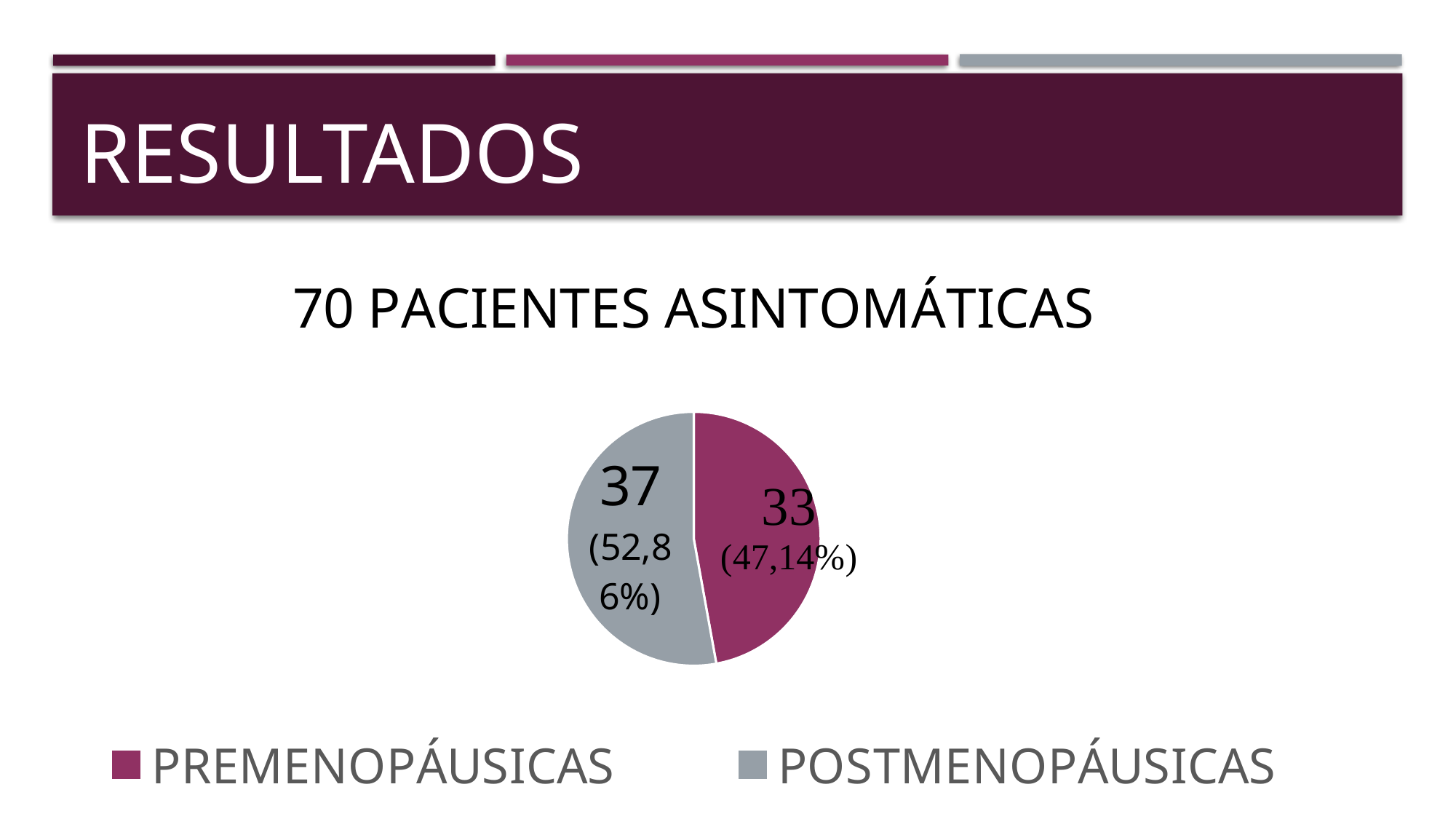
What is the difference between the number of POSTMENOPÁUSICAS and PREMENOPÁUSICAS patients? 4 What kind of chart is shown on the slide? pie chart What percentage of the pie is the POSTMENOPÁUSICAS slice? 52,86% Is the value for PREMENOPÁUSICAS larger or smaller than the value for POSTMENOPÁUSICAS? smaller How many patients are PREMENOPÁUSICAS? 33 How many entries does the legend list? 2 Which group has the smaller slice of the pie? PREMENOPÁUSICAS What colour is the PREMENOPÁUSICAS slice? purple How many slices does the pie chart have? 2 How many patients are POSTMENOPÁUSICAS? 37 Which group has the larger slice of the pie? POSTMENOPÁUSICAS What percentage of the pie is the PREMENOPÁUSICAS slice? 47,14%